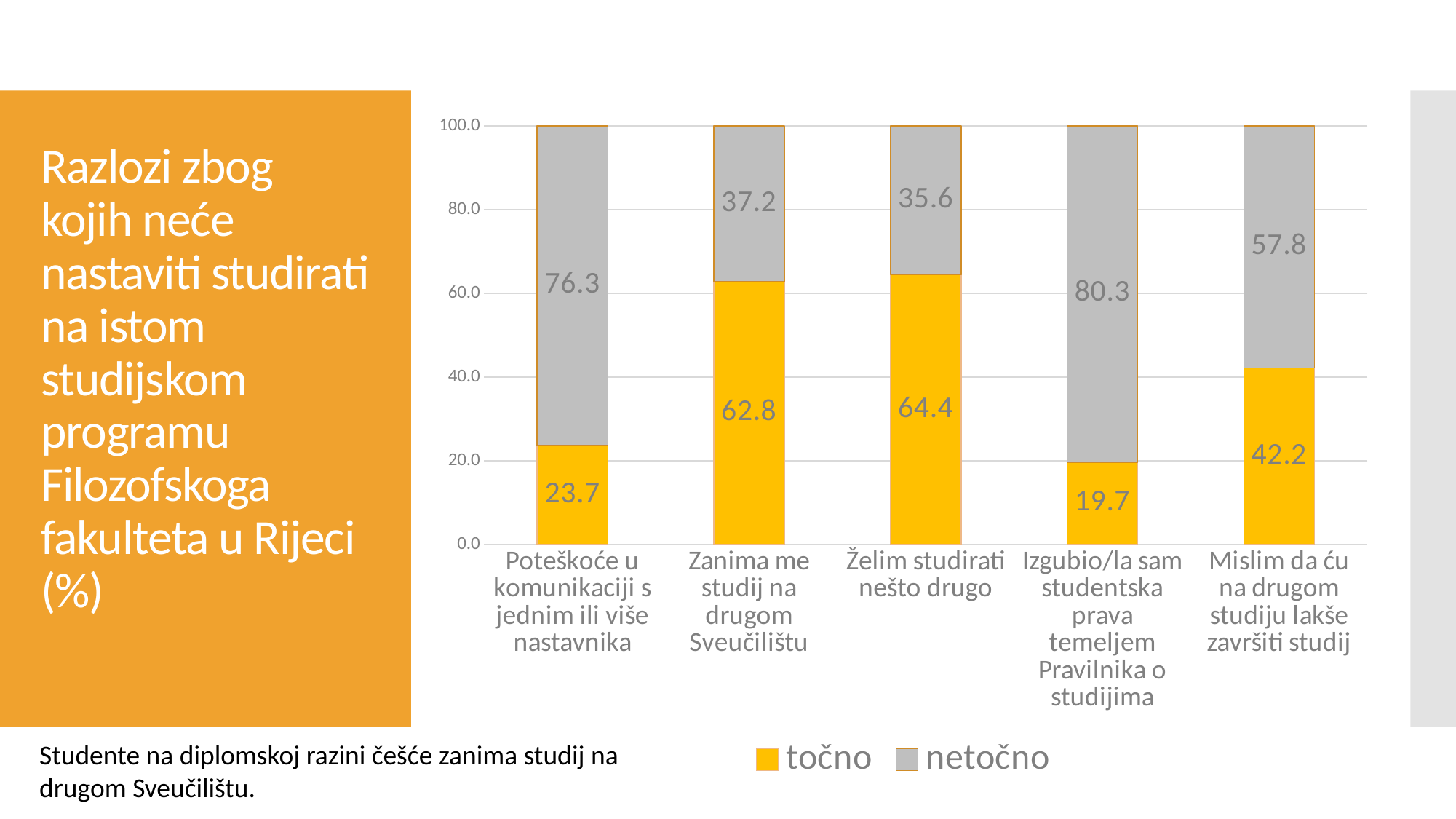
Which is larger: the 'točno' value for 'Poteškoće u komunikaciji s jednim ili više nastavnika' or for 'Mislim da ću na drugom studiju lakše završiti studij'? Mislim da ću na drugom studiju lakše završiti studij What is the 'točno' value for 'Zanima me studij na drugom Sveučilištu'? 62.8 Which category has the highest 'točno' value? Želim studirati nešto drugo What is the total of the stacked bar for 'Želim studirati nešto drugo'? 100.0 What is the 'točno' value for 'Mislim da ću na drugom studiju lakše završiti studij'? 42.2 What is the 'netočno' value for 'Izgubio/la sam studentska prava temeljem Pravilnika o studijima'? 80.3 How many series does the legend list? 2 Which colour represents the 'netočno' series? Grey Which category has the lowest 'točno' value? Izgubio/la sam studentska prava temeljem Pravilnika o studijima How many categories are shown on the x axis? 5 What is the difference between the 'netočno' values for 'Poteškoće u komunikaciji s jednim ili više nastavnika' and 'Zanima me studij na drugom Sveučilištu'? 39.1 What kind of chart is shown on the slide? Stacked bar chart